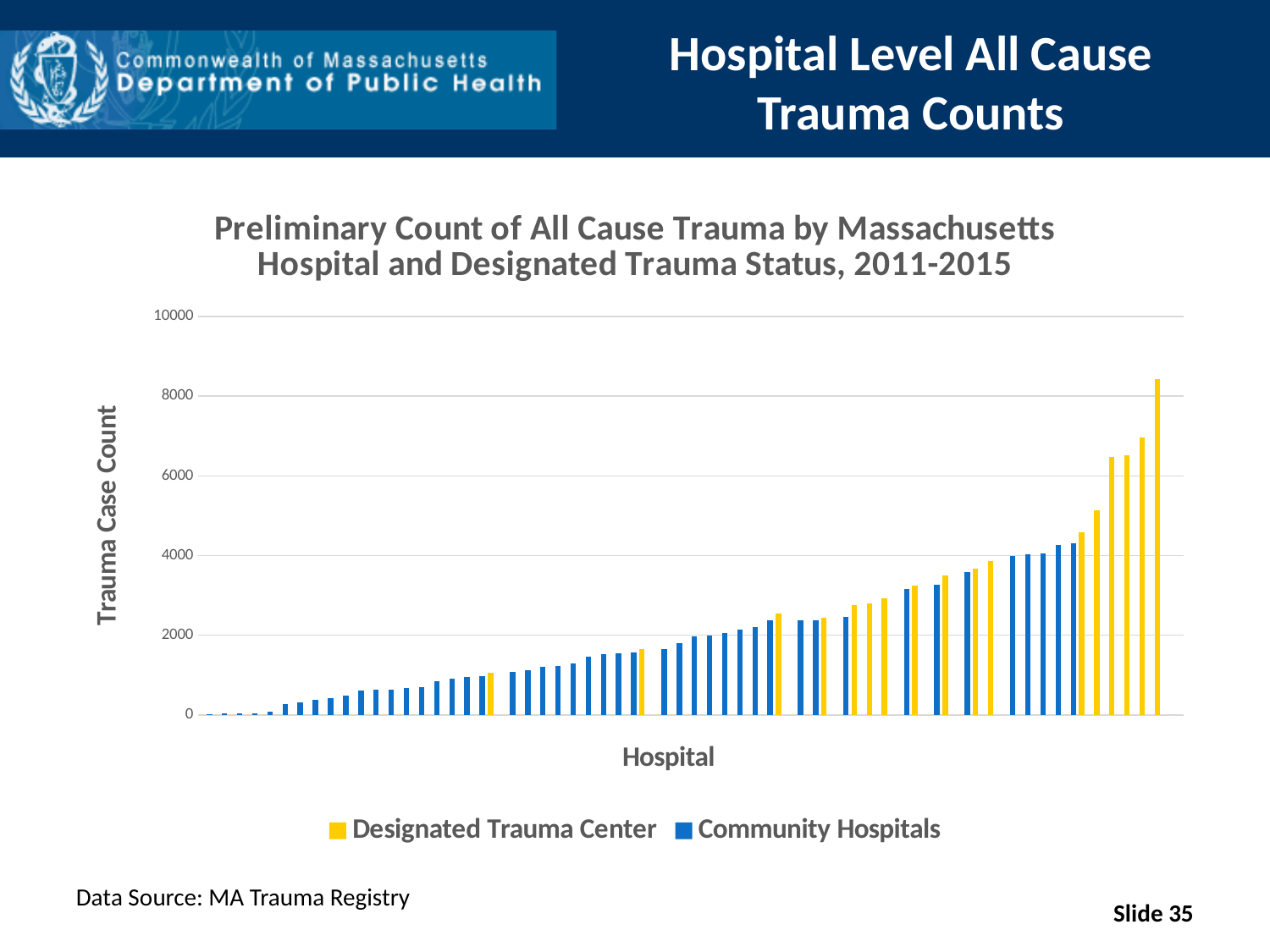
Is the value of the shortest bar greater or less than 2000? less Which series does the tallest bar in the chart belong to? Designated Trauma Center What kind of chart is shown on the slide? Bar chart What is the title of the chart? Preliminary Count of All Cause Trauma by Massachusetts Hospital and Designated Trauma Status, 2011-2015 Which series has the higher maximum value, Designated Trauma Center or Community Hospitals? Designated Trauma Center Is the value of the tallest Community Hospitals bar greater or less than 6000? less What is the highest value shown on the y axis? 10000 How many series does the chart's legend list? 2 Is the value of the tallest bar greater or less than 8000? greater What are the two series named in the chart's legend? Designated Trauma Center and Community Hospitals Do the bar values rise or fall from left to right along the x axis? Rise